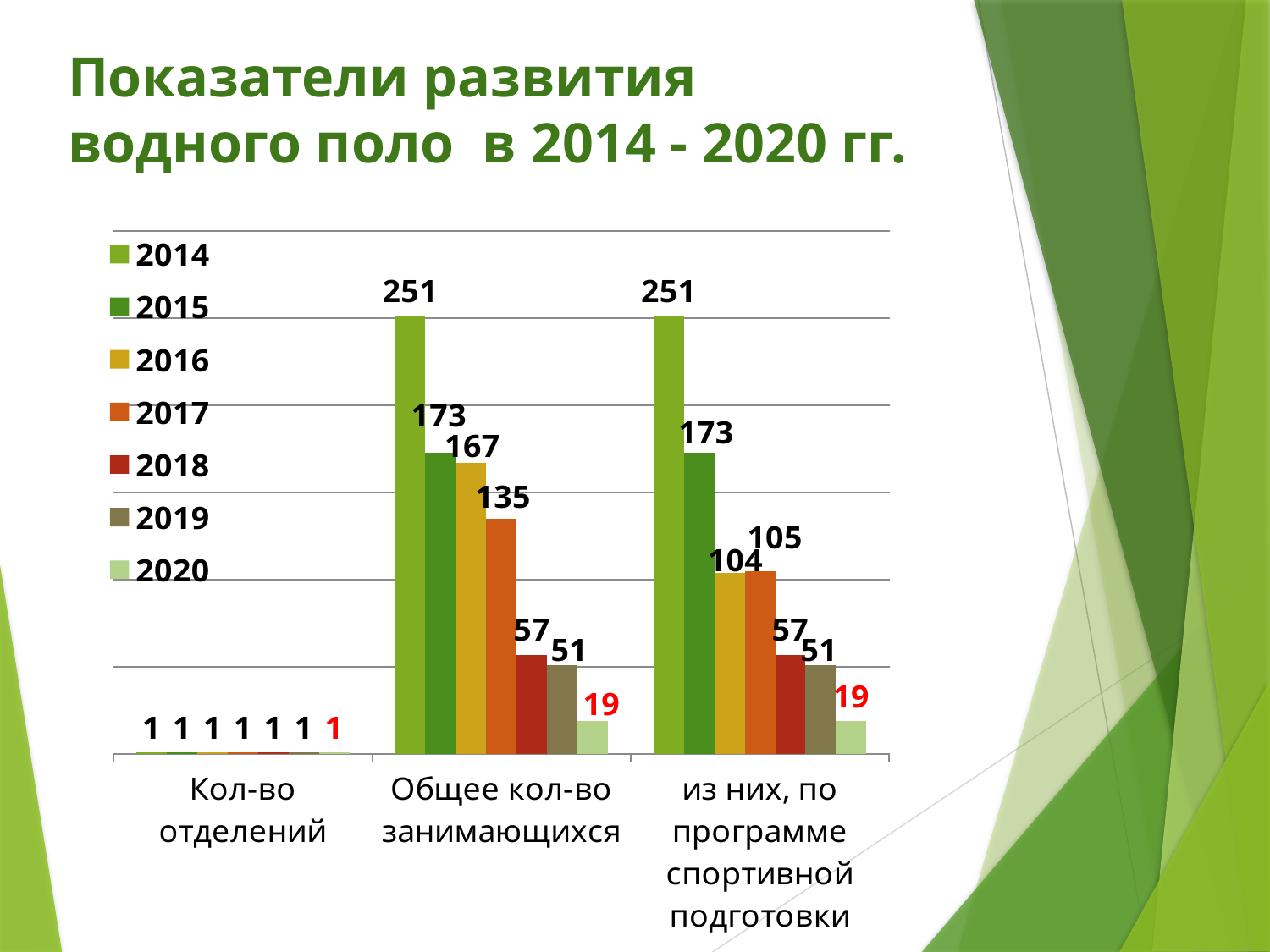
What is the value for 2014 in the category "Общее кол-во занимающихся"? 251 What is the value for 2020 in the category "Кол-во отделений"? 1 Do the values in the category "Общее кол-во занимающихся" rise or fall from 2014 to 2020? fall What kind of chart is shown on the slide? bar chart What is the value for 2016 in the category "из них, по программе спортивной подготовки"? 104 In the category "из них, по программе спортивной подготовки", which is larger: the value for 2016 or for 2017? 2017 What is the difference between the 2014 and 2020 values in the category "Общее кол-во занимающихся"? 232 How many series does the legend list? 7 What is the value for 2017 in the category "Общее кол-во занимающихся"? 135 How many categories are shown on the x axis? 3 Which year has the highest value in the category "Общее кол-во занимающихся"? 2014 Which year has the lowest value in the category "из них, по программе спортивной подготовки"? 2020